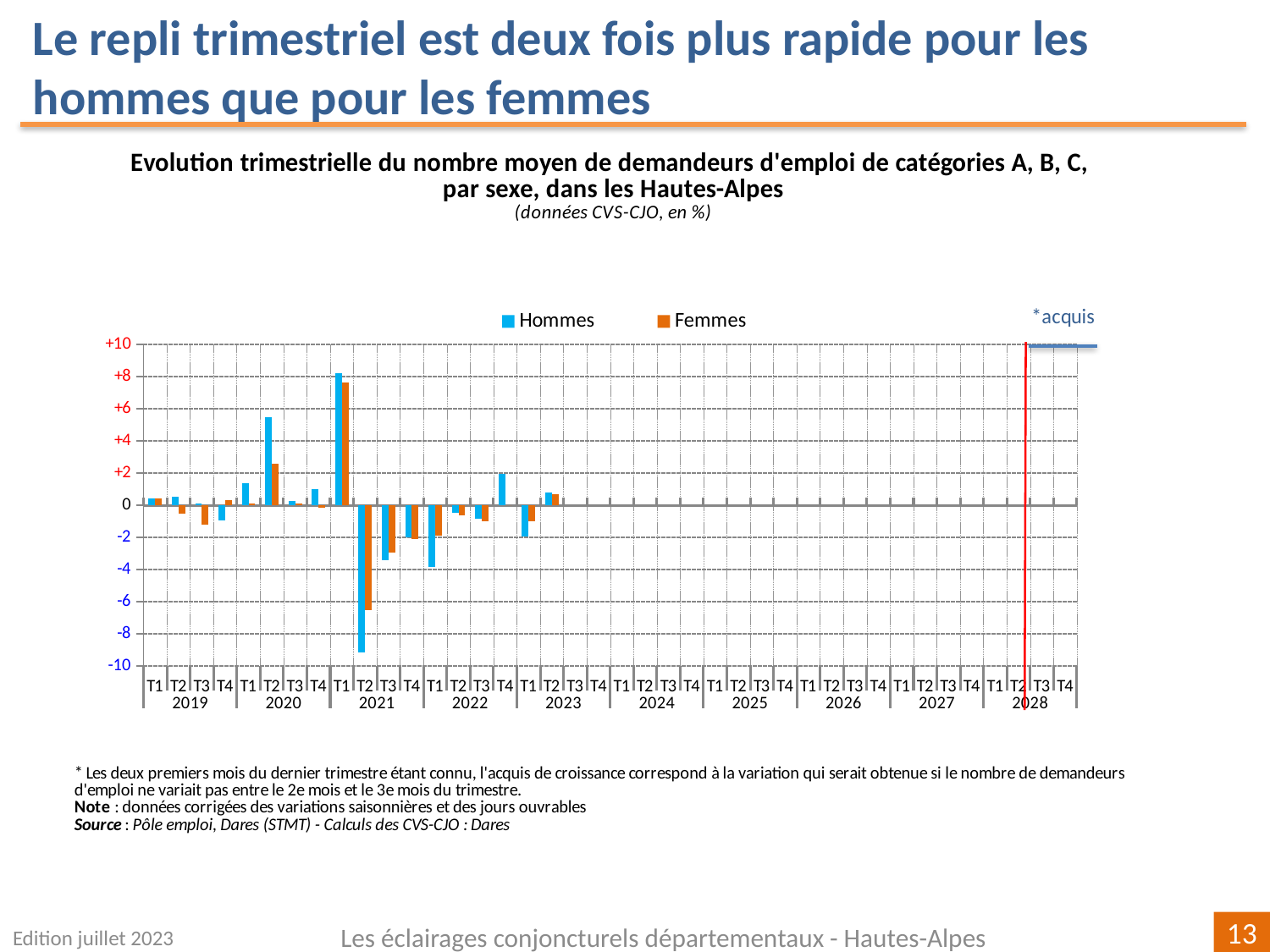
In which quarter does the Hommes series reach its highest value? T1 2021 In T2 2020, which series has the larger value, Hommes or Femmes? Hommes In which quarter does the Hommes series reach its lowest value? T2 2021 Is the value for Hommes in T2 2020 greater or less than +4? greater How many series does the legend list? 2 What are the two series named in the legend? Hommes and Femmes Is the value for Femmes in T1 2021 greater or less than +6? greater Is the value for Femmes in T2 2020 greater or less than +2? greater In T2 2021, which series has the lower value, Hommes or Femmes? Hommes What kind of chart is shown on the slide? bar chart In which quarter does the Femmes series reach its lowest value? T2 2021